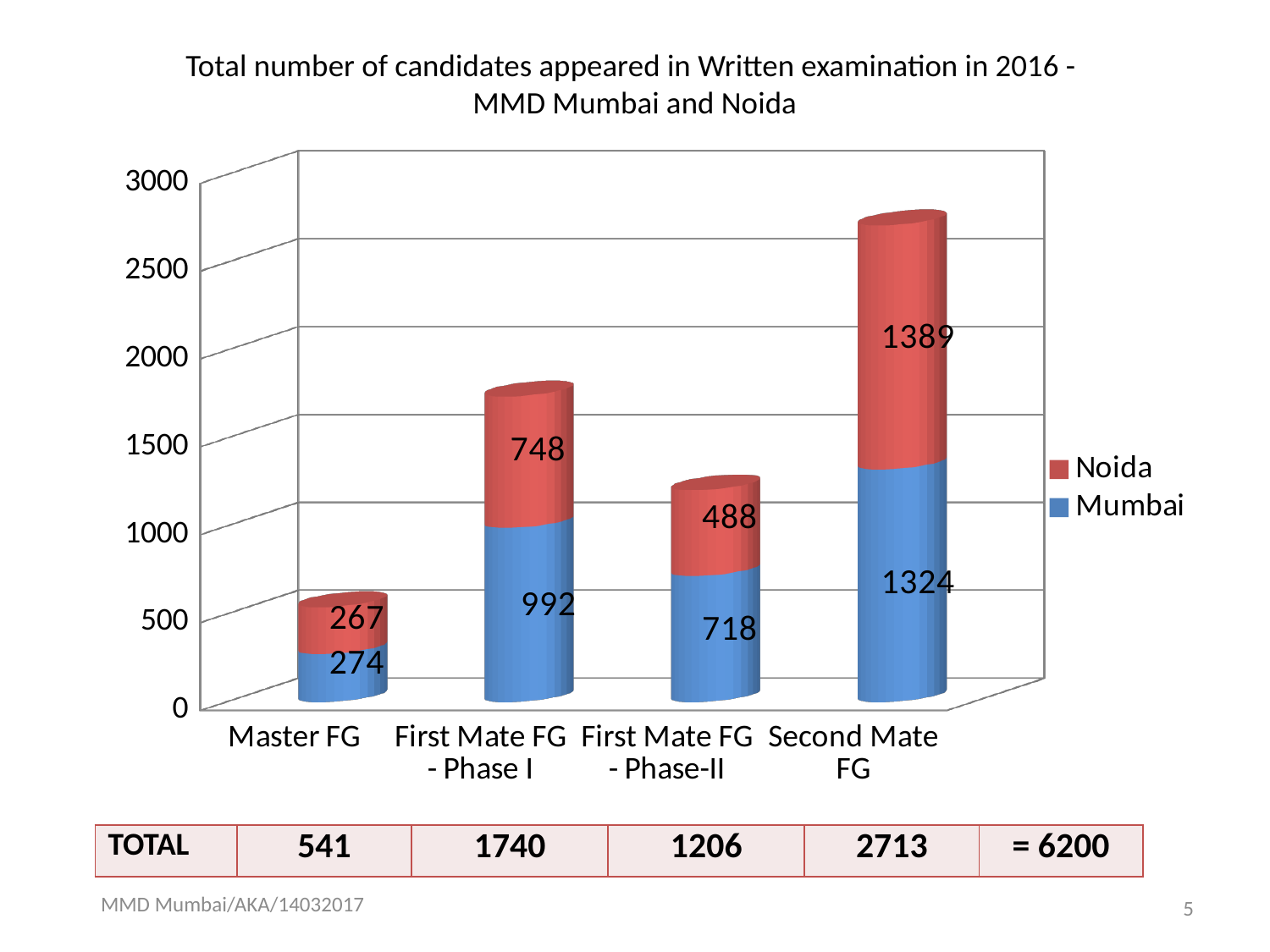
What is the Noida value for First Mate FG - Phase I? 748 How many series does the legend list? 2 How many categories are shown on the x axis? 4 Which category has the highest Noida value? Second Mate FG What is the Noida value for First Mate FG - Phase-II? 488 What is the Mumbai value for Master FG? 274 Which is larger for First Mate FG - Phase I, the Mumbai value or the Noida value? Mumbai What is the difference between the Noida and Mumbai values for First Mate FG - Phase-II? 230 What is the total of the stacked bar for Second Mate FG? 2713 What kind of chart is shown on the slide? Stacked bar chart Which category has the lowest Mumbai value? Master FG What is the Mumbai value for Second Mate FG? 1324